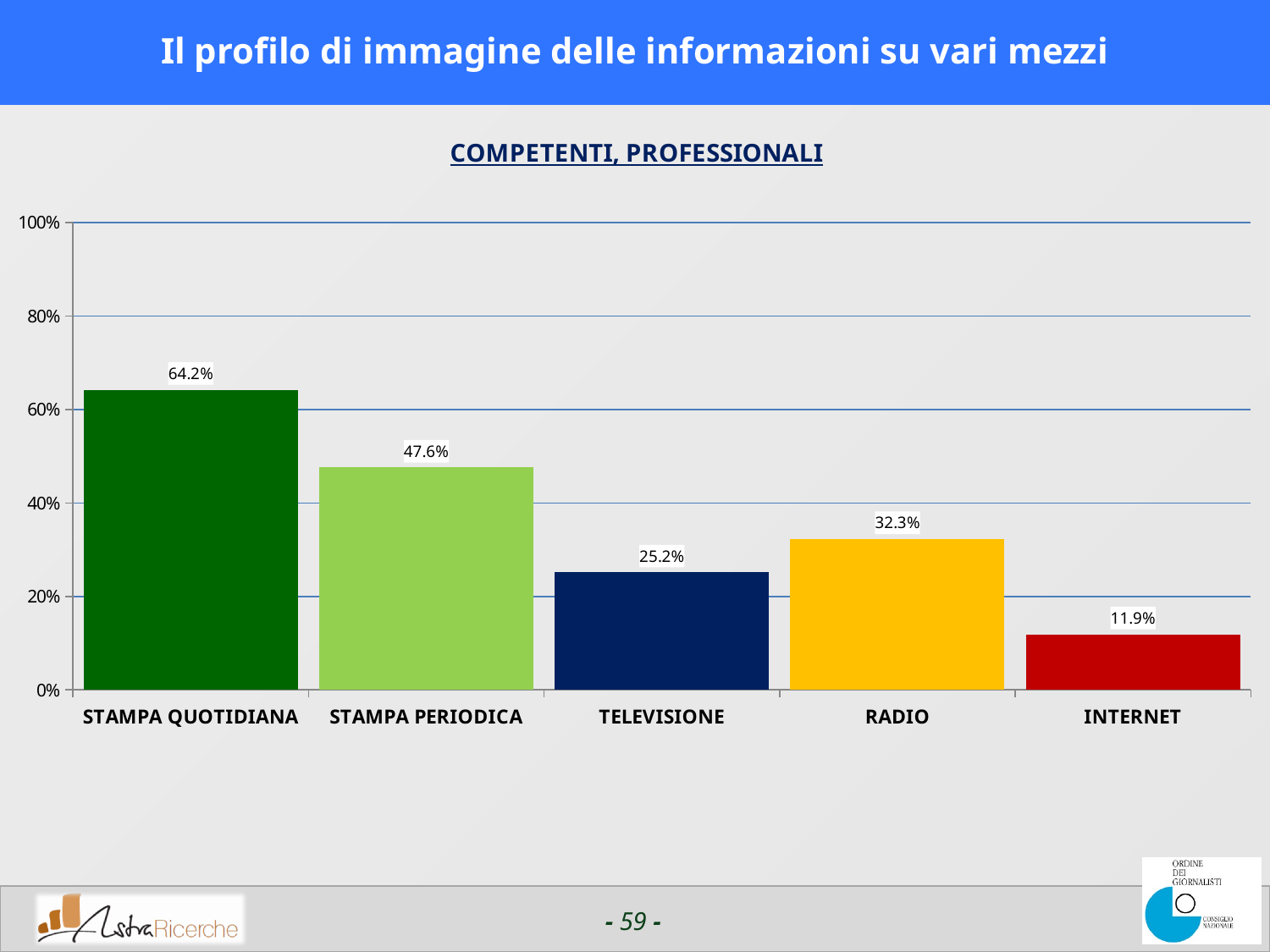
Which category has the highest value? STAMPA QUOTIDIANA What is the value for STAMPA QUOTIDIANA? 64.2% Which category has the lowest value? INTERNET What kind of chart is shown on the slide? bar chart What is the value for INTERNET? 11.9% What is the value for TELEVISIONE? 25.2% What is the difference between the values for RADIO and TELEVISIONE? 7.1% What is the difference between the values for STAMPA QUOTIDIANA and STAMPA PERIODICA? 16.6% How many categories are shown on the x axis? 5 Which is larger, the value for RADIO or the value for TELEVISIONE? RADIO What is the title shown above the chart? COMPETENTI, PROFESSIONALI Is the value for STAMPA PERIODICA greater or less than 40%? greater